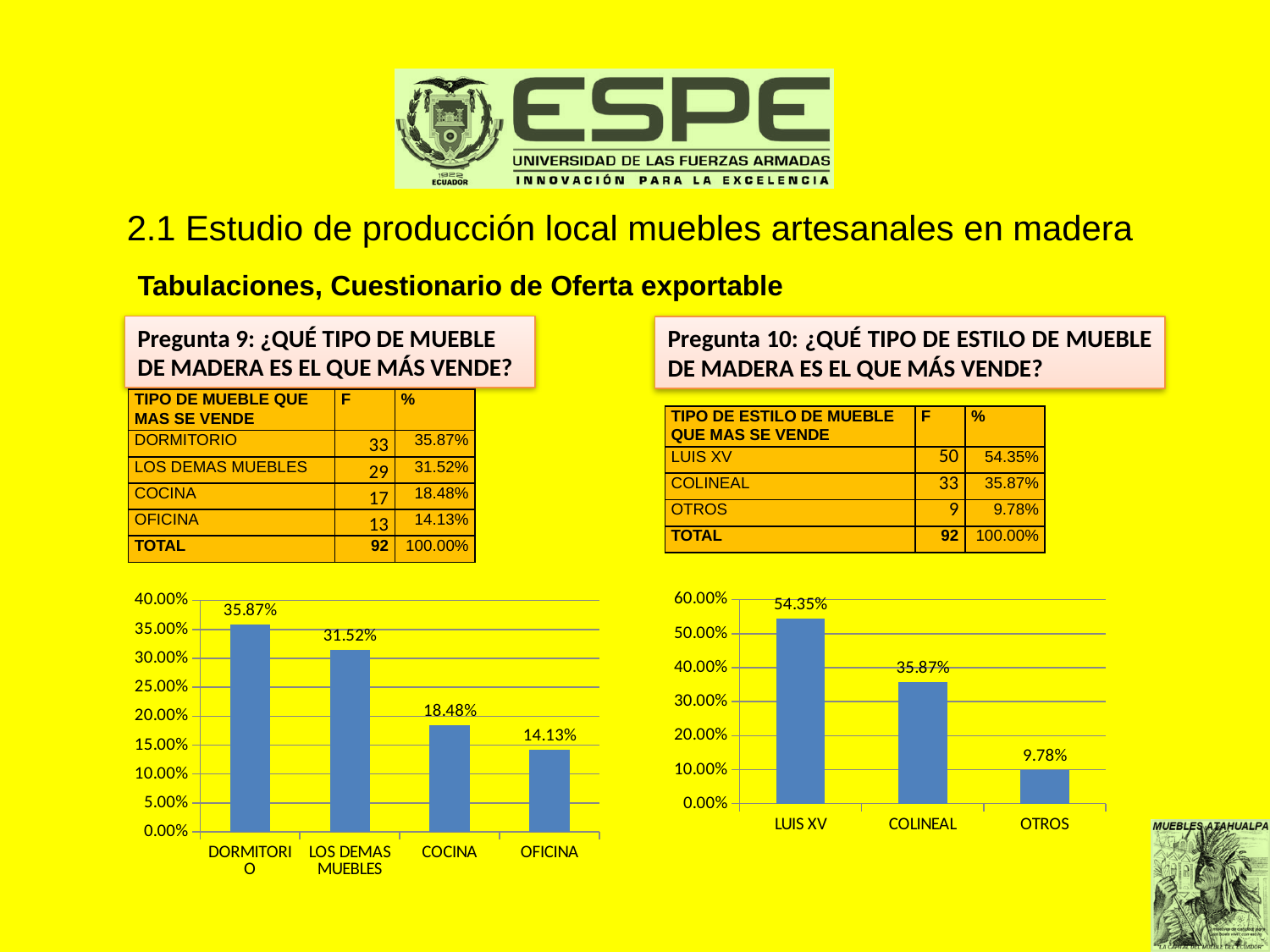
In the left chart (Pregunta 9), what is the difference between DORMITORIO and LOS DEMAS MUEBLES? 4.35% In the left chart (Pregunta 9), how many categories are plotted? 4 In the left chart (Pregunta 9), do the values rise or fall from left to right along the x axis? fall In the left chart (Pregunta 9), what is the value for COCINA? 18.48% In the right chart (Pregunta 10), what is the difference between LUIS XV and COLINEAL? 18.48% In the right chart (Pregunta 10), what is the value for LUIS XV? 54.35% In the left chart (Pregunta 9), what is the value for DORMITORIO? 35.87% In the right chart (Pregunta 10), what is the value for OTROS? 9.78% In the right chart (Pregunta 10), which category has the highest value? LUIS XV In the right chart (Pregunta 10), is the value for COLINEAL greater or less than 40.00%? less What type of chart is the right chart (Pregunta 10)? bar chart In the left chart (Pregunta 9), which category has the lowest value? OFICINA